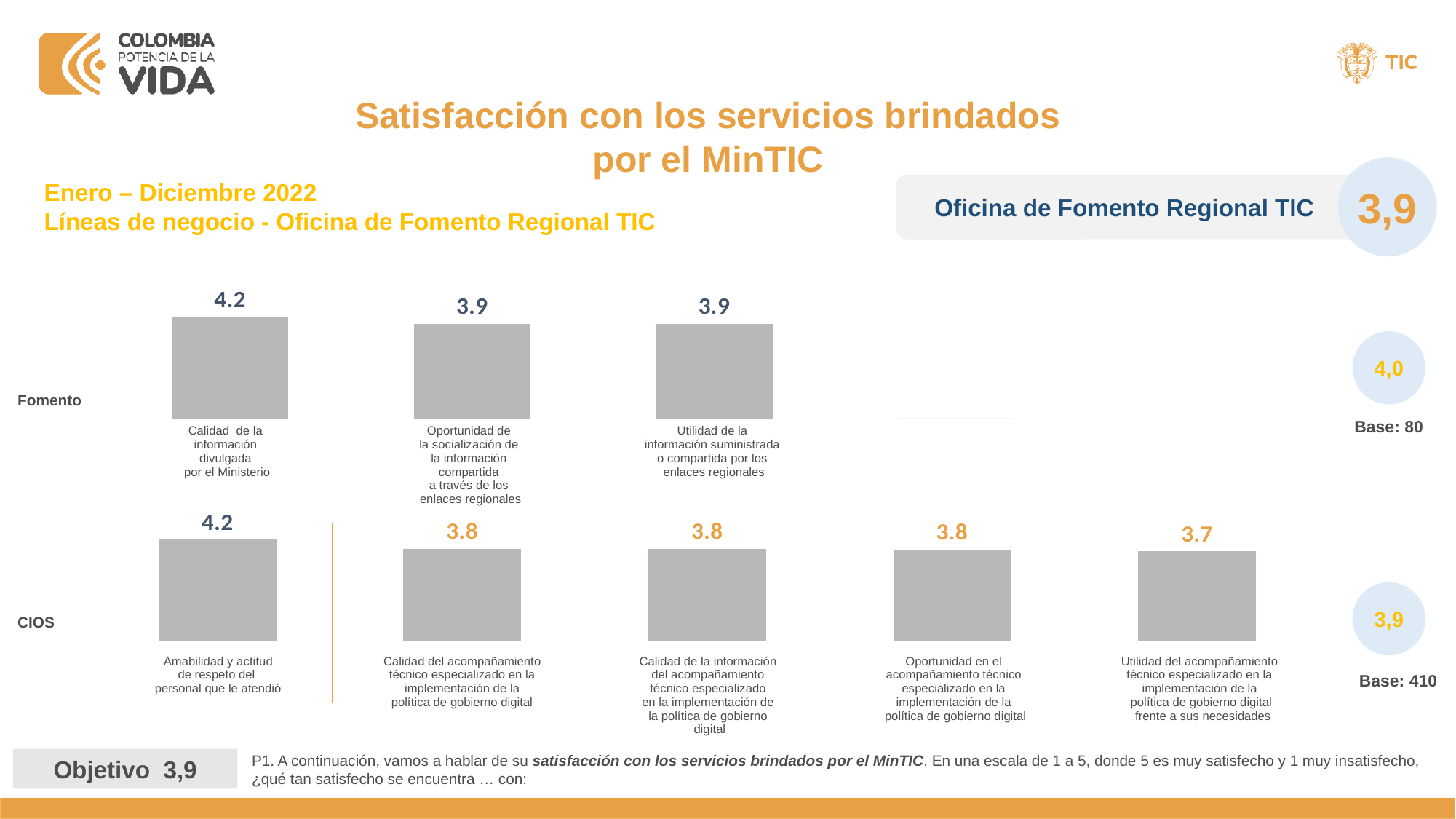
In the CIOS chart, what is the difference between 'Amabilidad y actitud de respeto del personal que le atendió' and 'Calidad del acompañamiento técnico especializado en la implementación de la política de gobierno digital'? 0.4 In the Fomento chart, what is the value for 'Calidad de la información divulgada por el Ministerio'? 4.2 In the CIOS chart, what is the value for 'Amabilidad y actitud de respeto del personal que le atendió'? 4.2 How many bars are shown in the Fomento chart? 3 In the Fomento chart, what is the difference between the highest and lowest values? 0.3 In the Fomento chart, what is the value for 'Utilidad de la información suministrada o compartida por los enlaces regionales'? 3.9 In the Fomento chart, which category has the highest value? Calidad de la información divulgada por el Ministerio In the CIOS chart, which category has the lowest value? Utilidad del acompañamiento técnico especializado en la implementación de la política de gobierno digital frente a sus necesidades In the CIOS chart, what is the value for 'Utilidad del acompañamiento técnico especializado en la implementación de la política de gobierno digital frente a sus necesidades'? 3.7 What type of chart is used for the CIOS row? Bar chart Which is larger in the CIOS chart: the value for 'Amabilidad y actitud de respeto del personal que le atendió' or the value for 'Oportunidad en el acompañamiento técnico especializado en la implementación de la política de gobierno digital'? Amabilidad y actitud de respeto del personal que le atendió How many bars are shown in the CIOS chart? 5